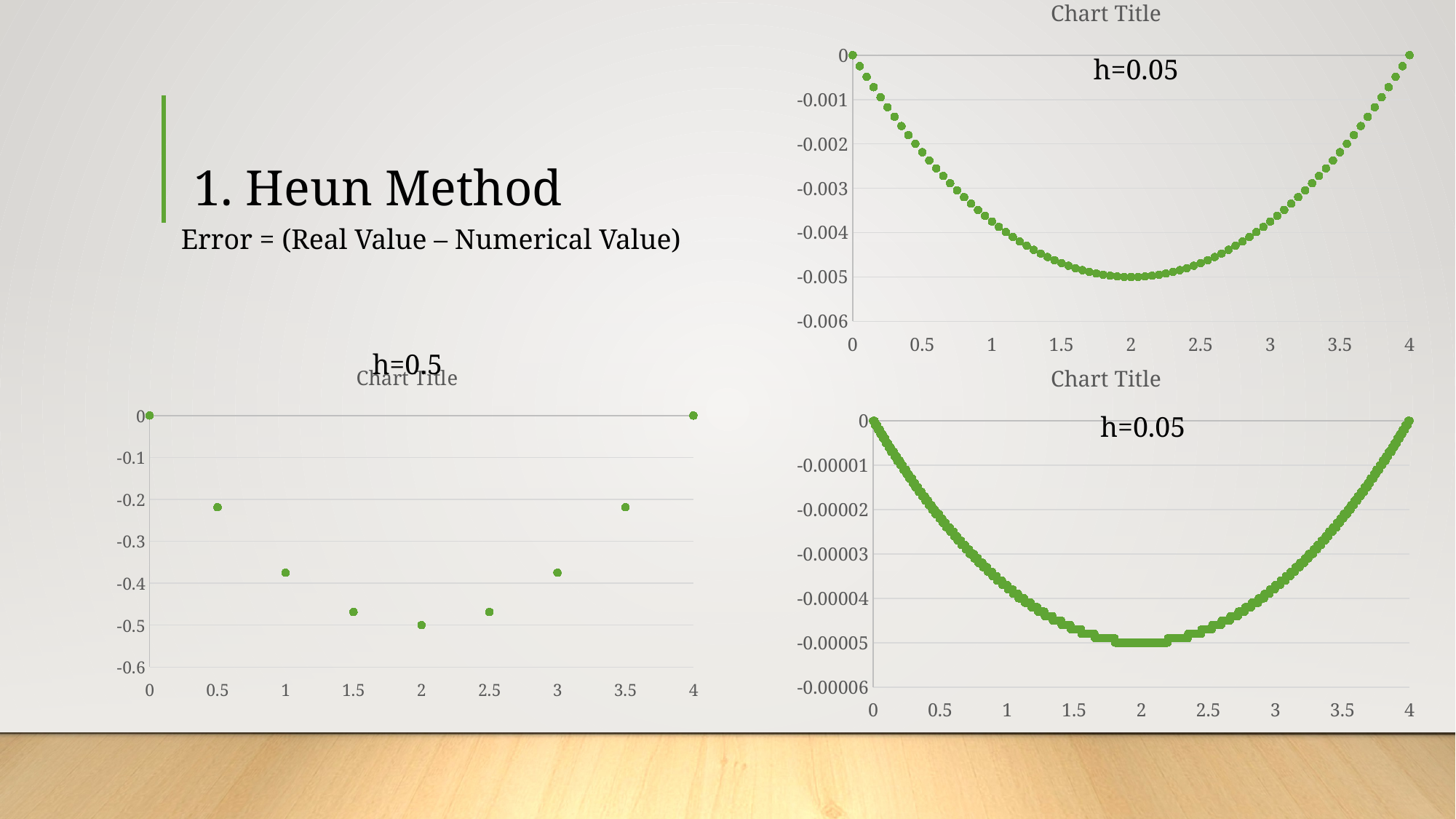
What kind of chart is the bottom-left chart labelled h=0.5? scatter chart In the bottom-left chart labelled h=0.5, is the value at x = 0.5 greater or less than -0.3? greater In the bottom-left chart labelled h=0.5, do the values rise or fall as x goes from 2 to 4? rise In the bottom-left chart labelled h=0.5, what is the value at x = 0? 0 In the top-right chart, is the value at x = 2 greater or less than -0.004? less In the bottom-left chart labelled h=0.5, how many data points are plotted? 9 In the bottom-right chart, is the value at x = 2 greater or less than -0.00004? less In the top-right chart, do the values rise or fall as x goes from 0 to 2? fall In the bottom-left chart labelled h=0.5, what is the value at x = 4? 0 In the bottom-left chart labelled h=0.5, which is larger, the value at x = 1 or the value at x = 2? x = 1 In the bottom-left chart labelled h=0.5, at which x value is the plotted value lowest? 2